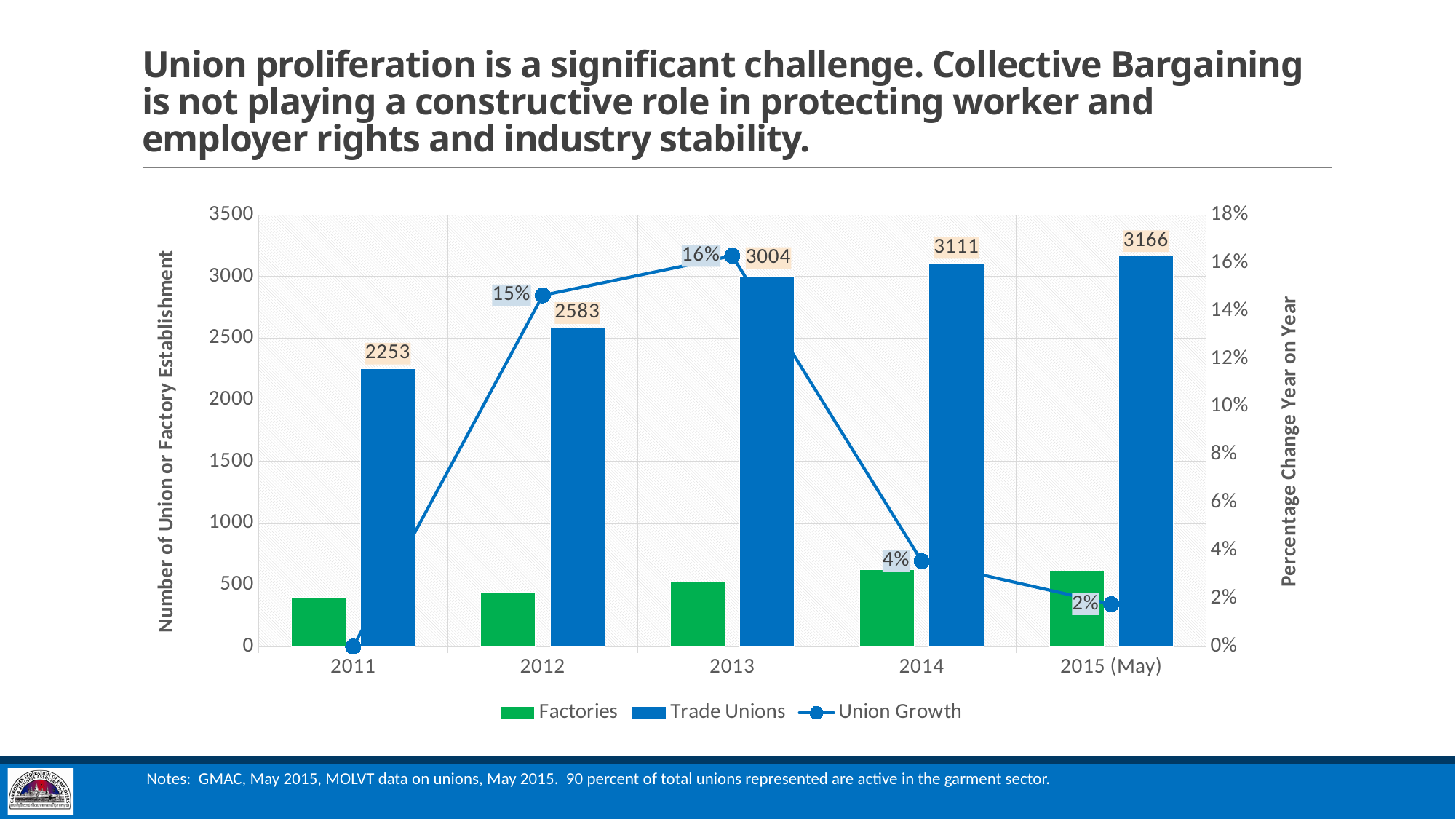
What is the value for Trade Unions in 2015 (May)? 3166 How many series does the legend list? 3 What is the Union Growth value for 2012? 15% In which year is the Trade Unions value highest? 2015 (May) Which year has the larger Union Growth value, 2013 or 2014? 2013 In which year is the Trade Unions value lowest? 2011 How many years are shown on the x axis? 5 Is the value for Factories in 2011 greater or less than 500? less What is the difference between the Trade Unions values for 2015 (May) and 2011? 913 What is the value for Trade Unions in 2013? 3004 Do the Trade Unions values rise or fall from 2011 to 2015 (May)? rise Is the value for Factories in 2014 greater or less than 500? greater